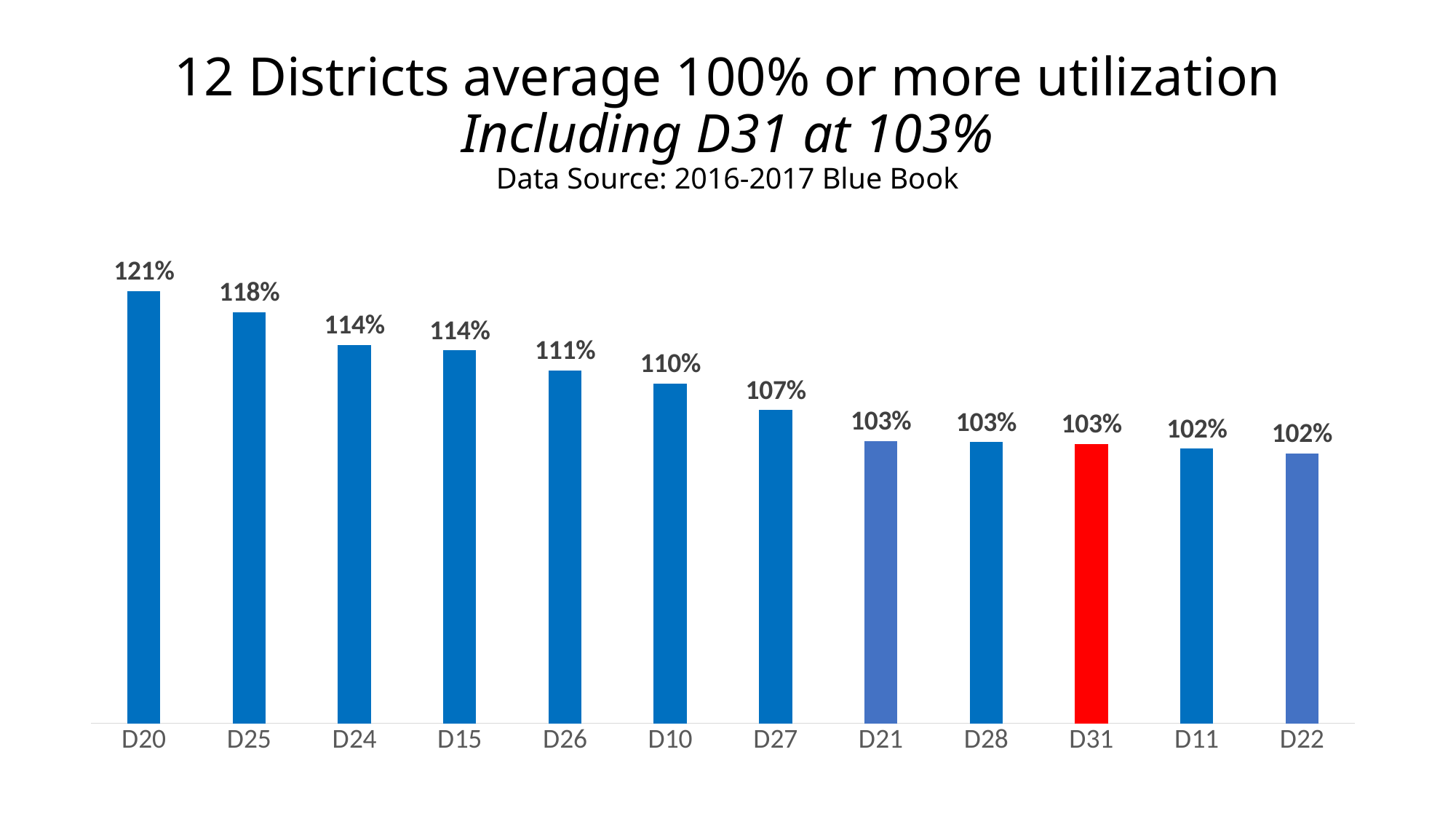
What is the difference between the utilization of D20 and D25? 3% How many districts are shown in the chart? 12 Which district's bar is coloured red? D31 Which district has the highest utilization? D20 What is the utilization value for D10? 110% What is the utilization value for D27? 107% Which has a higher utilization, D26 or D27? D26 What is the utilization value for D20? 121% What is the utilization value for D31? 103% Do the values rise or fall from left to right along the x axis? Fall What is the difference between the utilization of D25 and D31? 15% What kind of chart is shown on the slide? Bar chart